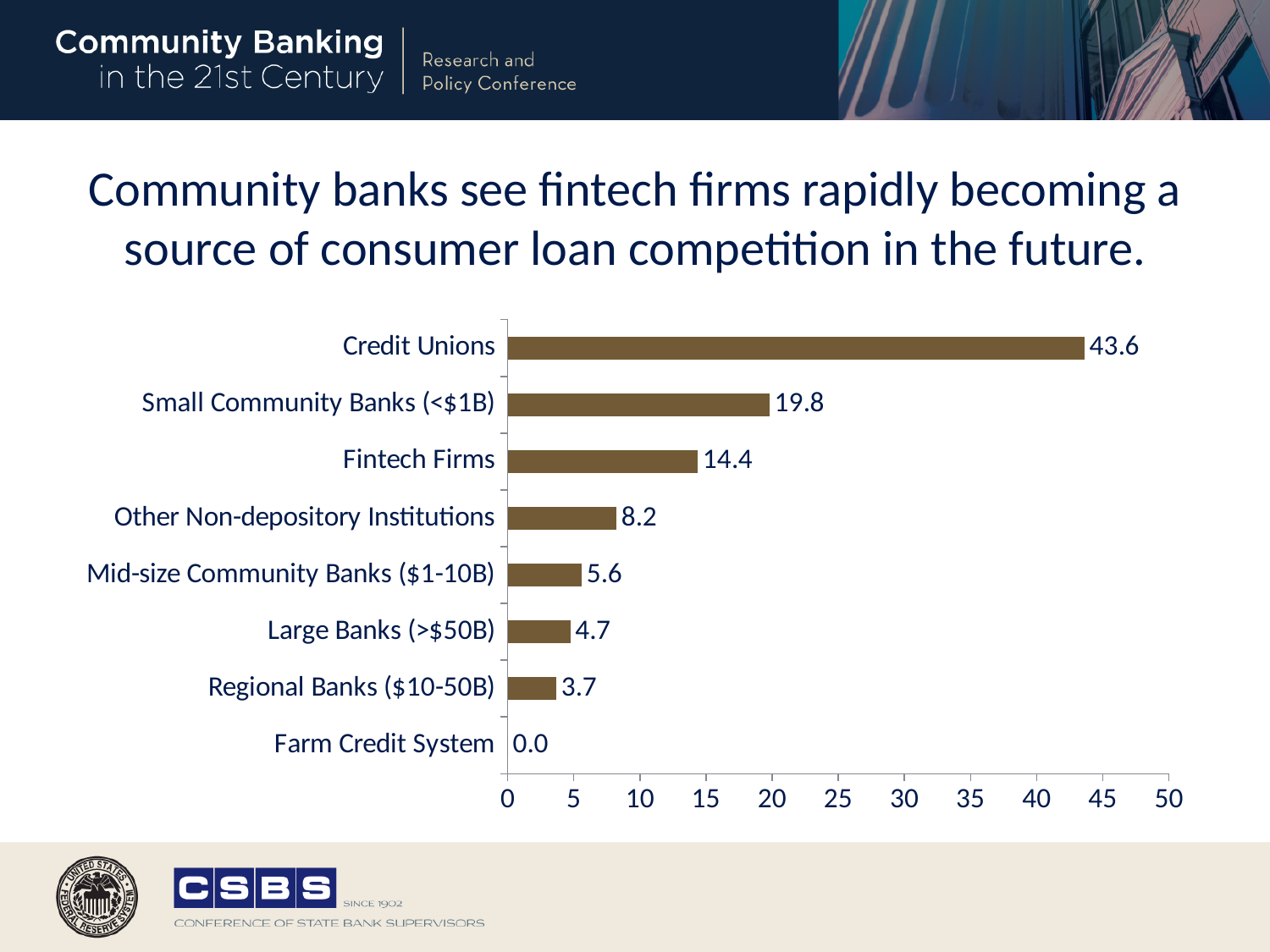
What is the value for Credit Unions? 43.6 Which is larger, the value for Mid-size Community Banks ($1-10B) or Large Banks (>$50B)? Mid-size Community Banks ($1-10B) Which category has the highest value? Credit Unions What is the difference between the values for Credit Unions and Small Community Banks (<$1B)? 23.8 What is the value for Other Non-depository Institutions? 8.2 What is the difference between the values for Fintech Firms and Other Non-depository Institutions? 6.2 Is the value for Small Community Banks (<$1B) greater or less than 15? greater What is the value for Fintech Firms? 14.4 Which category has the lowest value? Farm Credit System What is the value for Regional Banks ($10-50B)? 3.7 What kind of chart is shown on the slide? bar chart How many categories are shown in the chart? 8